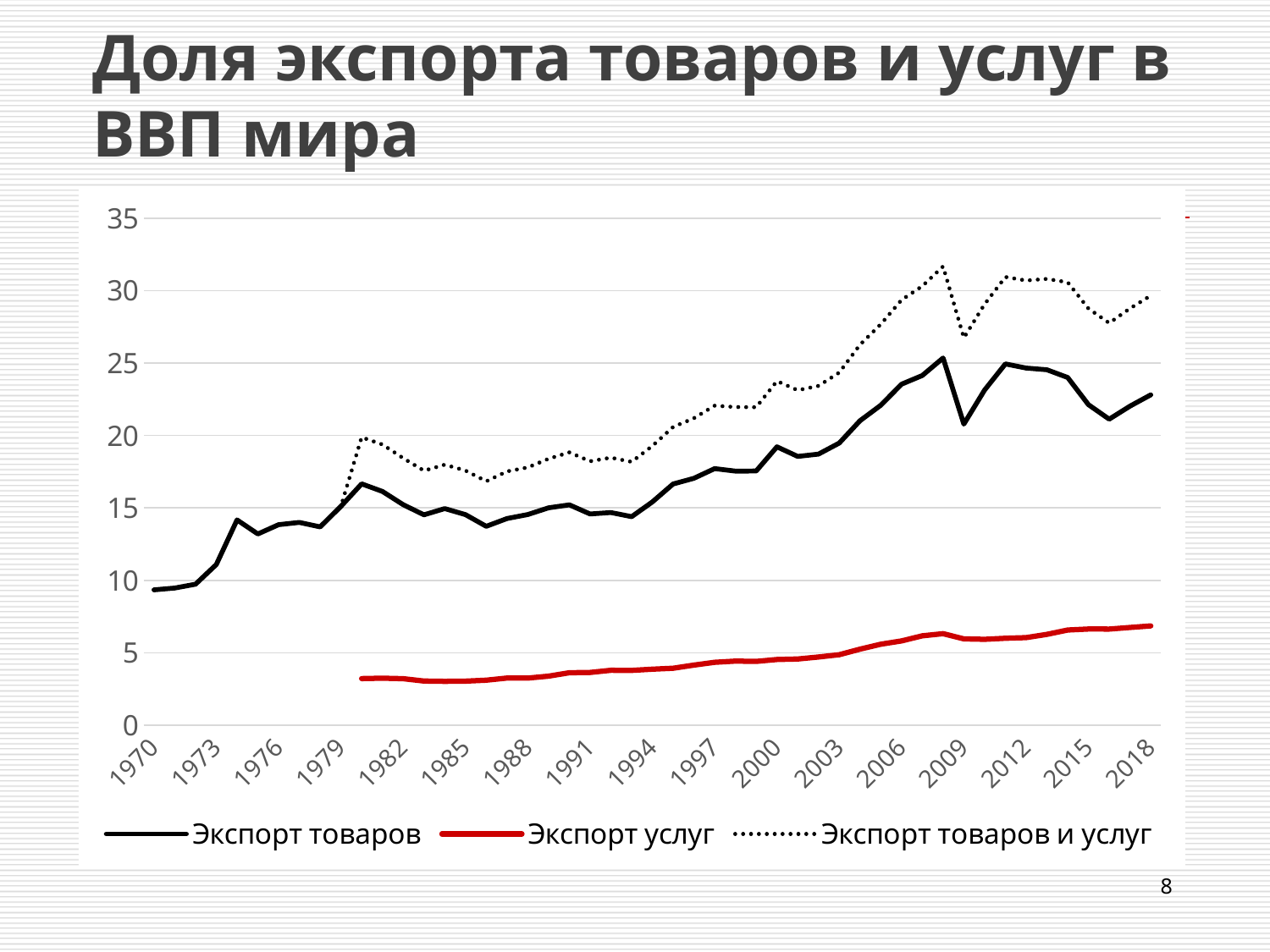
What kind of chart is shown on the slide? line chart Which series has the highest values across the whole chart? Экспорт товаров и услуг How many series does the legend list? 3 Which series is drawn with a red line? Экспорт услуг Which is larger for Экспорт товаров: the value in 2008 or the value in 2009? 2008 Is the value for Экспорт товаров и услуг in 2008 greater or less than 30? greater Does the Экспорт услуг line generally rise or fall from 1980 to 2018? rise Is the value for Экспорт услуг in 2018 greater or less than 5? greater What is the title of the chart on the slide? Доля экспорта товаров и услуг в ВВП мира Is the value for Экспорт товаров in 2006 greater or less than 20? greater Which series has the lowest values across the whole chart? Экспорт услуг